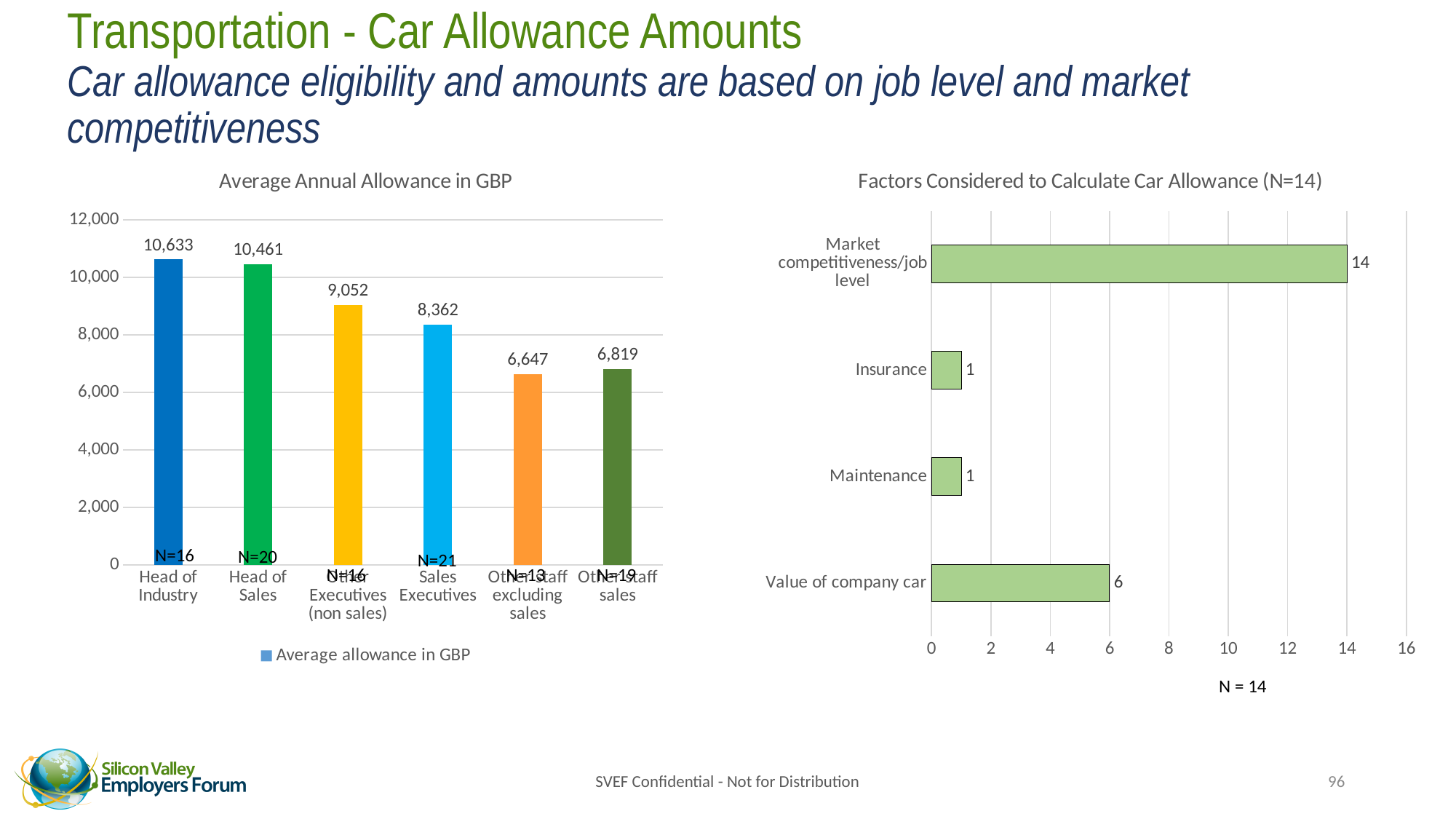
In the 'Average Annual Allowance in GBP' chart, what is the value for Head of Industry? 10,633 In the 'Average Annual Allowance in GBP' chart, how many categories are shown? 6 In the 'Average Annual Allowance in GBP' chart, what is the difference between Head of Sales and Other Executives (non sales)? 1,409 In the 'Factors Considered to Calculate Car Allowance (N=14)' chart, which factor has the highest value? Market competitiveness/job level In the 'Factors Considered to Calculate Car Allowance (N=14)' chart, what is the difference between Market competitiveness/job level and Value of company car? 8 In the 'Average Annual Allowance in GBP' chart, what is the value for Sales Executives? 8,362 In the 'Factors Considered to Calculate Car Allowance (N=14)' chart, what is the value for Value of company car? 6 In the 'Average Annual Allowance in GBP' chart, which category has the lowest value? Other staff excluding sales In the 'Average Annual Allowance in GBP' chart, what is the legend entry? Average allowance in GBP What kind of chart is 'Factors Considered to Calculate Car Allowance (N=14)'? Bar chart In the 'Factors Considered to Calculate Car Allowance (N=14)' chart, which is larger, Insurance or Value of company car? Value of company car In the 'Average Annual Allowance in GBP' chart, which category has the highest value? Head of Industry